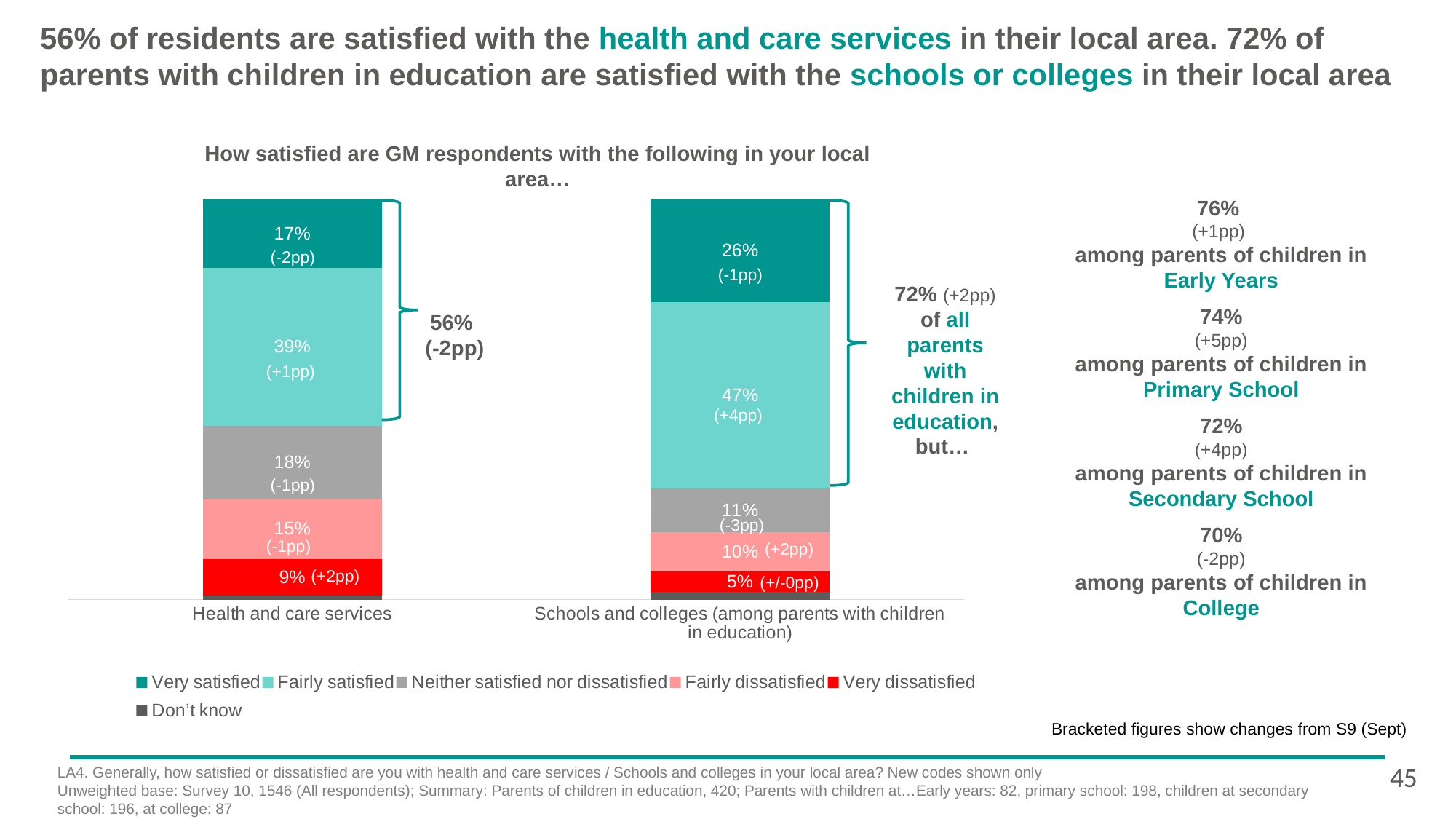
What percentage of parents are very dissatisfied with schools and colleges? 5% What percentage of parents with children in education are fairly satisfied with schools and colleges? 47% How many series does the legend list? 6 What is the difference between the fairly satisfied share for schools and colleges and the fairly satisfied share for health and care services? 8% What is the combined very satisfied and fairly satisfied share for health and care services, as shown by the bracket? 56% Which category has the larger very satisfied share, health and care services or schools and colleges? Schools and colleges What kind of chart is shown on the slide? Stacked bar chart How many categories (bars) are shown in the chart? 2 What percentage of respondents are neither satisfied nor dissatisfied with health and care services? 18% Which segment is the largest in the health and care services bar? Fairly satisfied What percentage of respondents are very satisfied with health and care services? 17% Which labelled segment is the smallest in the schools and colleges bar? Very dissatisfied